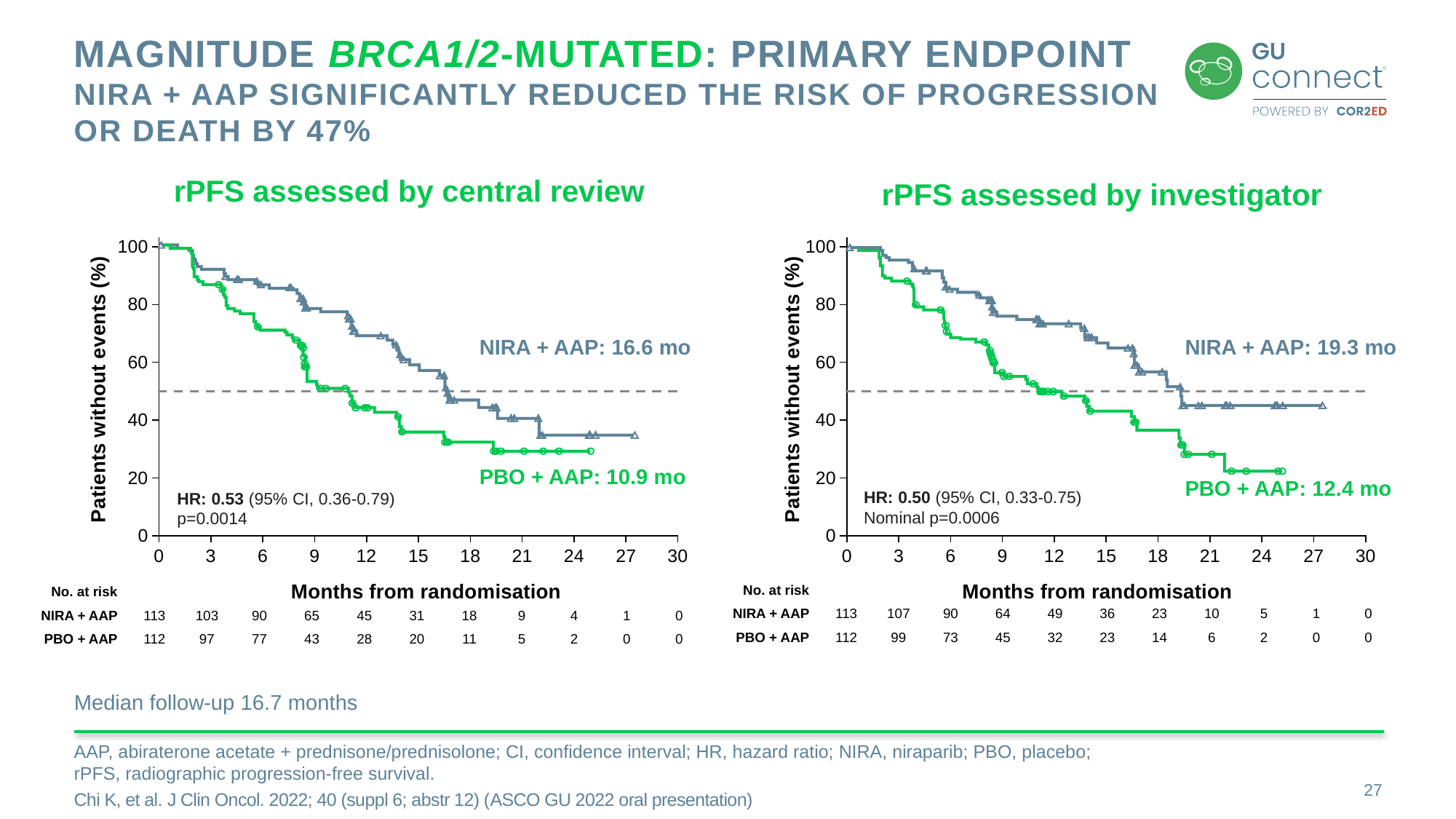
In the chart titled 'rPFS assessed by central review', which arm has the longer median rPFS, NIRA + AAP or PBO + AAP? NIRA + AAP In the chart titled 'rPFS assessed by central review', what is the hazard ratio shown? 0.53 In the chart titled 'rPFS assessed by central review', what is the median rPFS for PBO + AAP? 10.9 mo In the chart titled 'rPFS assessed by central review', what is the median rPFS for NIRA + AAP? 16.6 mo In the chart titled 'rPFS assessed by central review', what is the difference in median rPFS between NIRA + AAP and PBO + AAP? 5.7 mo In the chart titled 'rPFS assessed by central review', how many NIRA + AAP patients were at risk at 9 months? 65 In the chart titled 'rPFS assessed by central review', is the NIRA + AAP curve at 24 months greater or less than 40%? less In the chart titled 'rPFS assessed by investigator', how many PBO + AAP patients were at risk at 12 months? 32 In the chart titled 'rPFS assessed by investigator', what is the median rPFS for NIRA + AAP? 19.3 mo In the chart titled 'rPFS assessed by investigator', what is the difference in median rPFS between NIRA + AAP and PBO + AAP? 6.9 mo In the chart titled 'rPFS assessed by investigator', what is the median rPFS for PBO + AAP? 12.4 mo In the chart titled 'rPFS assessed by investigator', what is the hazard ratio shown? 0.50